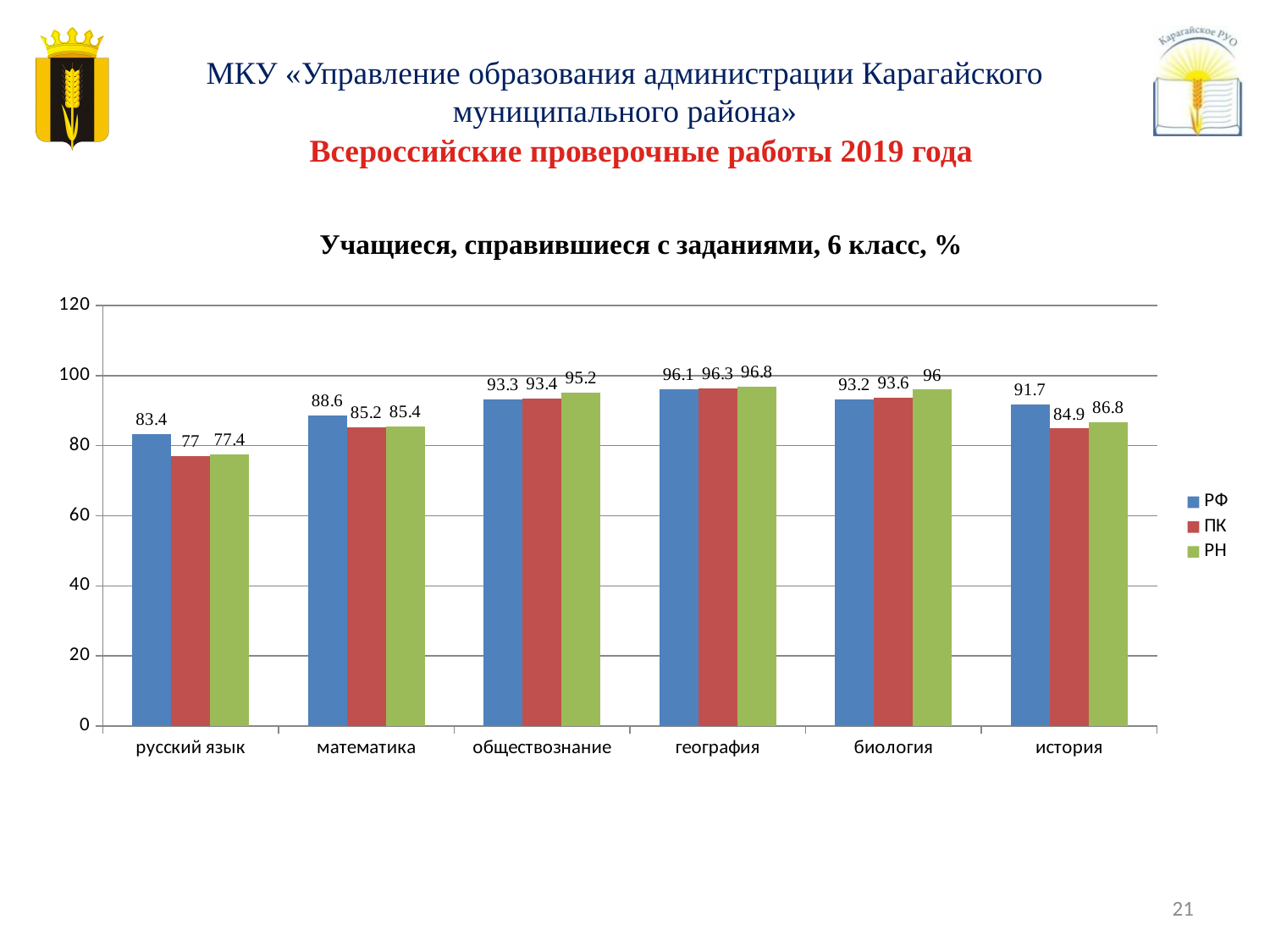
What is the difference between the РФ and ПК values for русский язык? 6.4 What is the value for РН in обществознание? 95.2 Which subject has the highest value for РН? география How many series does the legend list? 3 Which subject has the lowest value for ПК? русский язык Is the value for ПК in математика greater or less than 80? greater What kind of chart is shown on the slide? bar chart What is the value for РФ in русский язык? 83.4 What is the value for ПК in история? 84.9 How many subjects are shown on the x axis? 6 Which is larger for история: the РФ value or the РН value? РФ What is the title of the chart? Учащиеся, справившиеся с заданиями, 6 класс, %